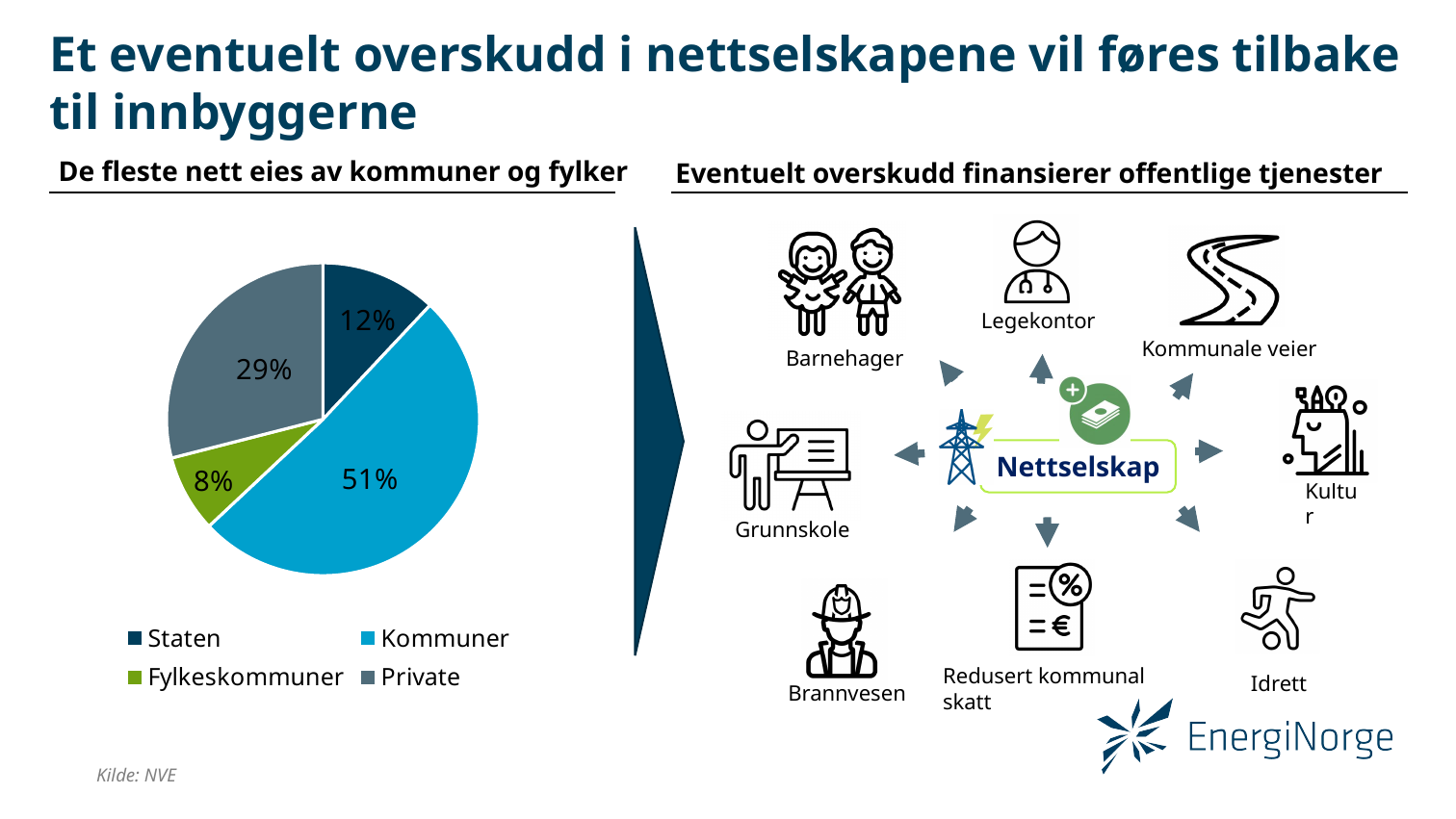
Which slice is larger, Staten or Private? Private What is the heading above the pie chart? De fleste nett eies av kommuner og fylker What share of the pie chart does Kommuner hold? 51% What share of the pie chart does Private hold? 29% What type of chart is shown on the slide? pie chart Which category has the largest slice in the pie chart? Kommuner What share of the pie chart does Staten hold? 12% How many categories does the pie chart show? 4 How many entries does the legend of the pie chart list? 4 What is the difference in percentage points between the Kommuner and Private slices? 22 Which category has the smallest slice in the pie chart? Fylkeskommuner